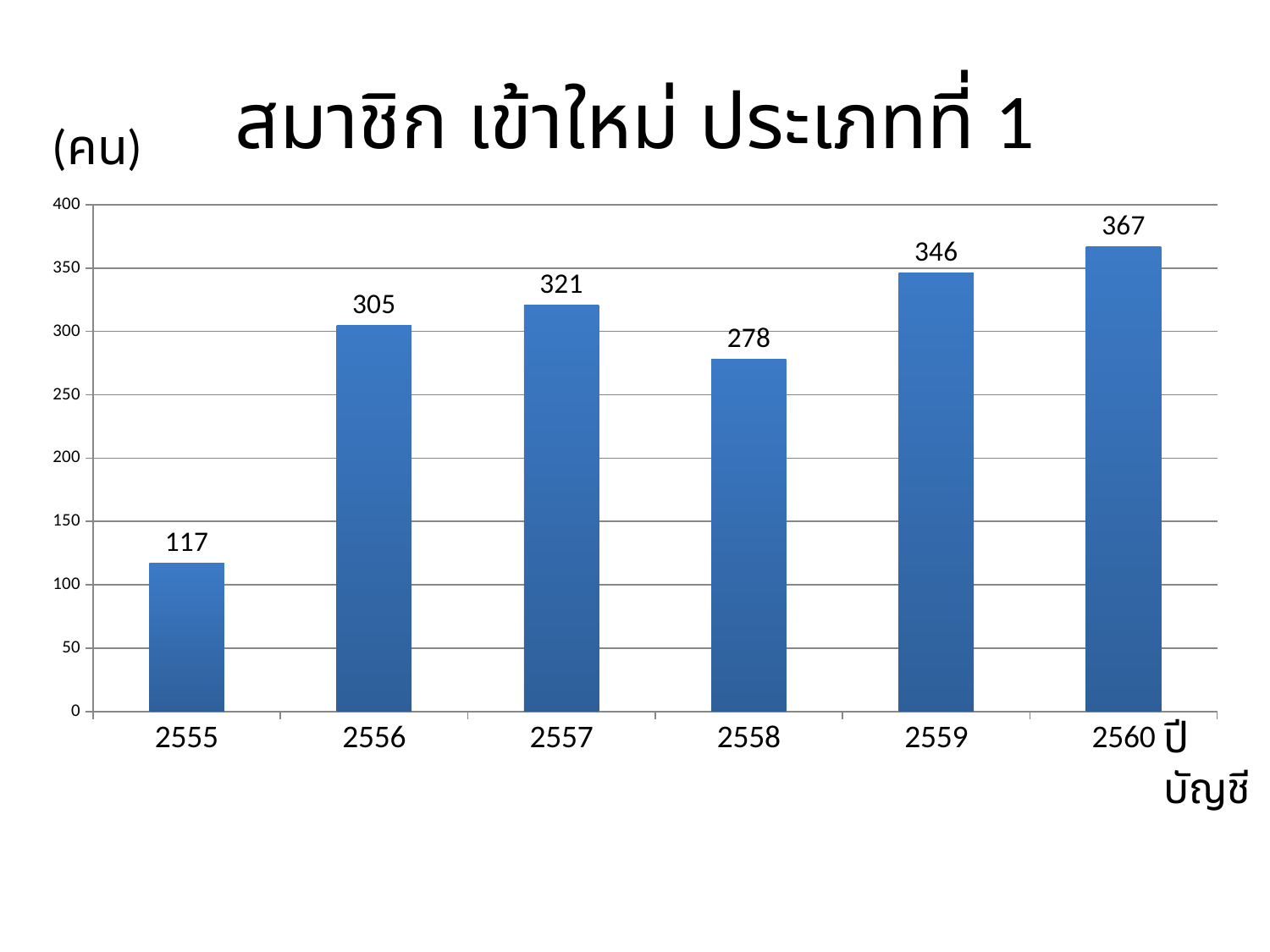
What is the difference between the values for 2557 and 2558? 43 What kind of chart is shown on the slide? bar chart What is the value for 2555? 117 Which year has the lowest value? 2555 What is the title of the chart? สมาชิก เข้าใหม่ ประเภทที่ 1 What is the value for 2558? 278 What is the value for 2560? 367 Which is larger, the value for 2556 or the value for 2559? 2559 Is the value for 2557 greater or less than 300? greater How many years are shown on the x axis? 6 What is the difference between the values for 2560 and 2555? 250 Which year has the highest value? 2560